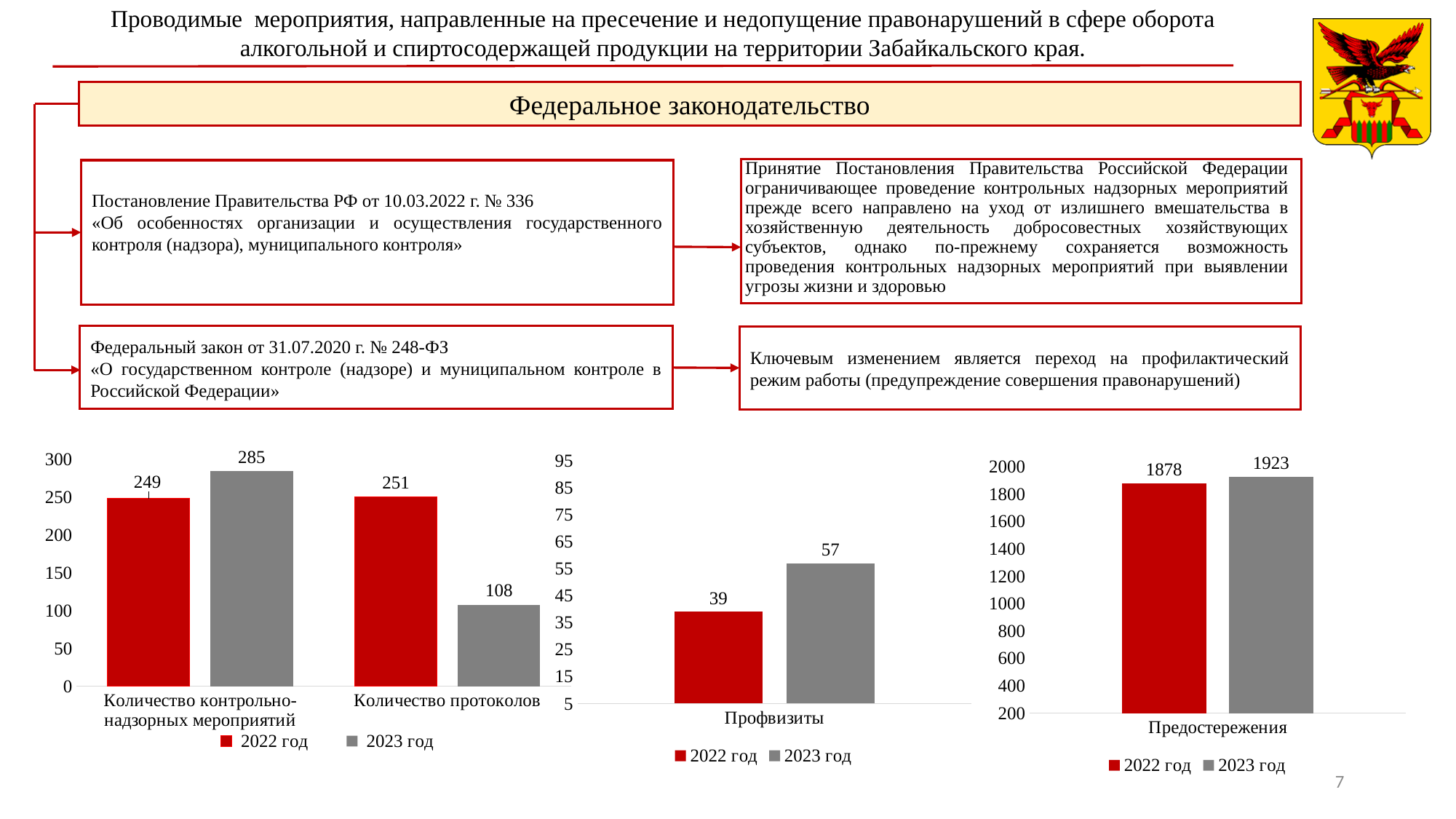
What type of chart is the middle chart? bar chart In the right chart, what is the value for Предостережения in 2022 год? 1878 In the left chart, how many categories are shown on the x axis? 2 In the middle chart, is the 2022 год value for Профвизиты greater or less than 45? less In the middle chart, what is the difference between the 2023 год and 2022 год values for Профвизиты? 18 In the left chart, what is the value for 2023 год for Количество протоколов? 108 In the left chart, what is the difference between the 2023 год and 2022 год values for Количество контрольно-надзорных мероприятий? 36 In the left chart, which year has the larger value for Количество протоколов? 2022 год In the middle chart, what is the value for Профвизиты in 2023 год? 57 In the left chart, what is the value for 2022 год for Количество контрольно-надзорных мероприятий? 249 In the right chart, what is the difference between the 2023 год and 2022 год values for Предостережения? 45 How many series does the legend of the right chart list? 2